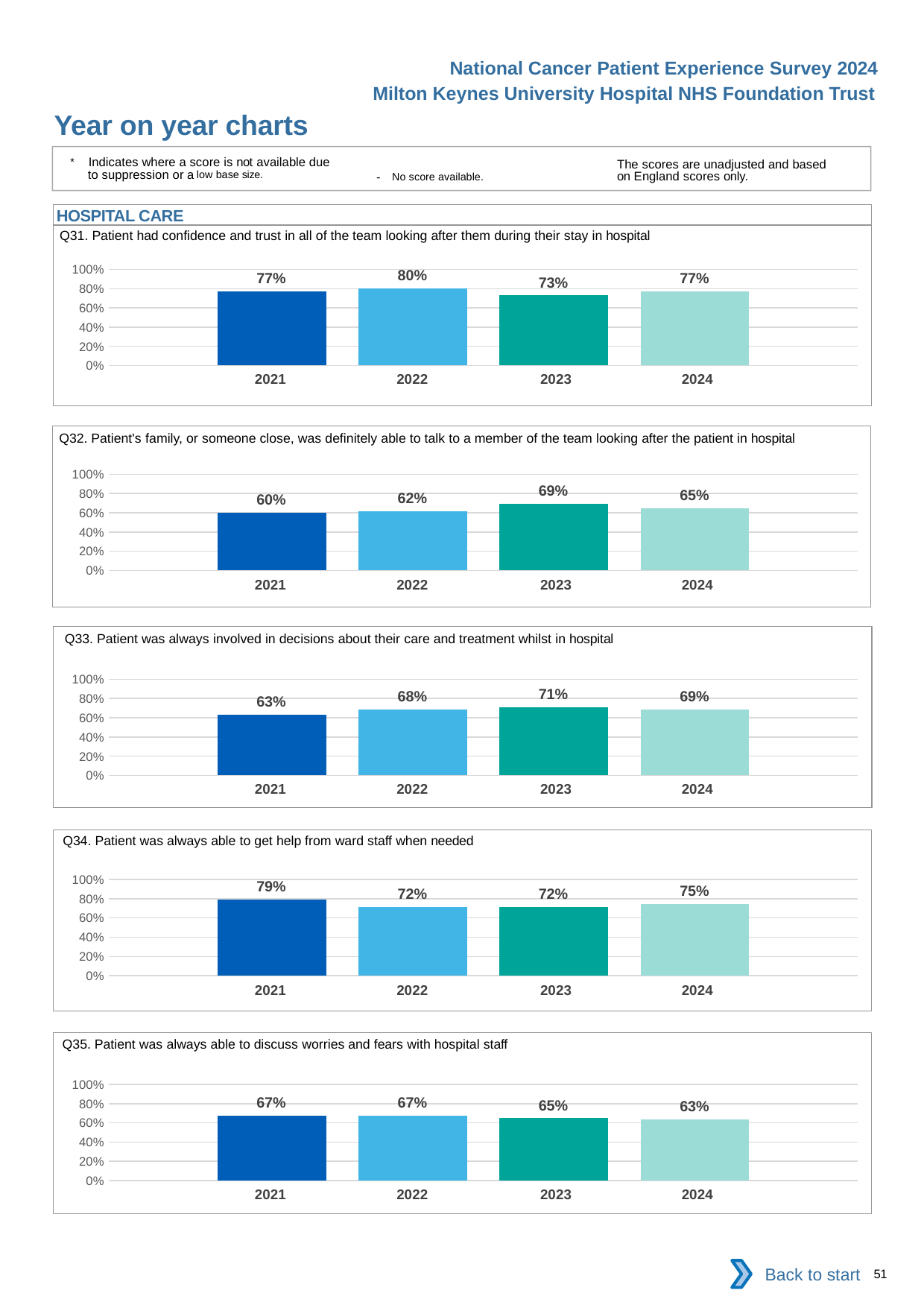
In the Q34 chart (patient was always able to get help from ward staff), what is the value for 2021? 79% In the Q32 chart (patient's family was definitely able to talk to a member of the team), what is the value for 2021? 60% In the Q33 chart (patient was always involved in decisions about their care), what is the value for 2024? 69% In the Q33 chart (patient was always involved in decisions about their care), which is larger, the 2022 value or the 2023 value? 2023 In the Q34 chart (patient was always able to get help from ward staff), what is the difference between the 2021 and 2024 values? 4 percentage points What kind of chart is the Q31 chart (patient had confidence and trust in all of the team)? bar chart In the Q32 chart (patient's family was definitely able to talk to a member of the team), what is the difference between the 2023 and 2021 values? 9 percentage points How many years are shown on the x axis of the Q35 chart (patient was always able to discuss worries and fears)? 4 In the Q35 chart (patient was always able to discuss worries and fears), do the values rise or fall from 2022 to 2024? fall In the Q31 chart (patient had confidence and trust in all of the team), which year has the lowest value? 2023 In the Q31 chart (patient had confidence and trust in all of the team), what is the value for 2022? 80% In the Q32 chart (patient's family was definitely able to talk to a member of the team), which year has the highest value? 2023